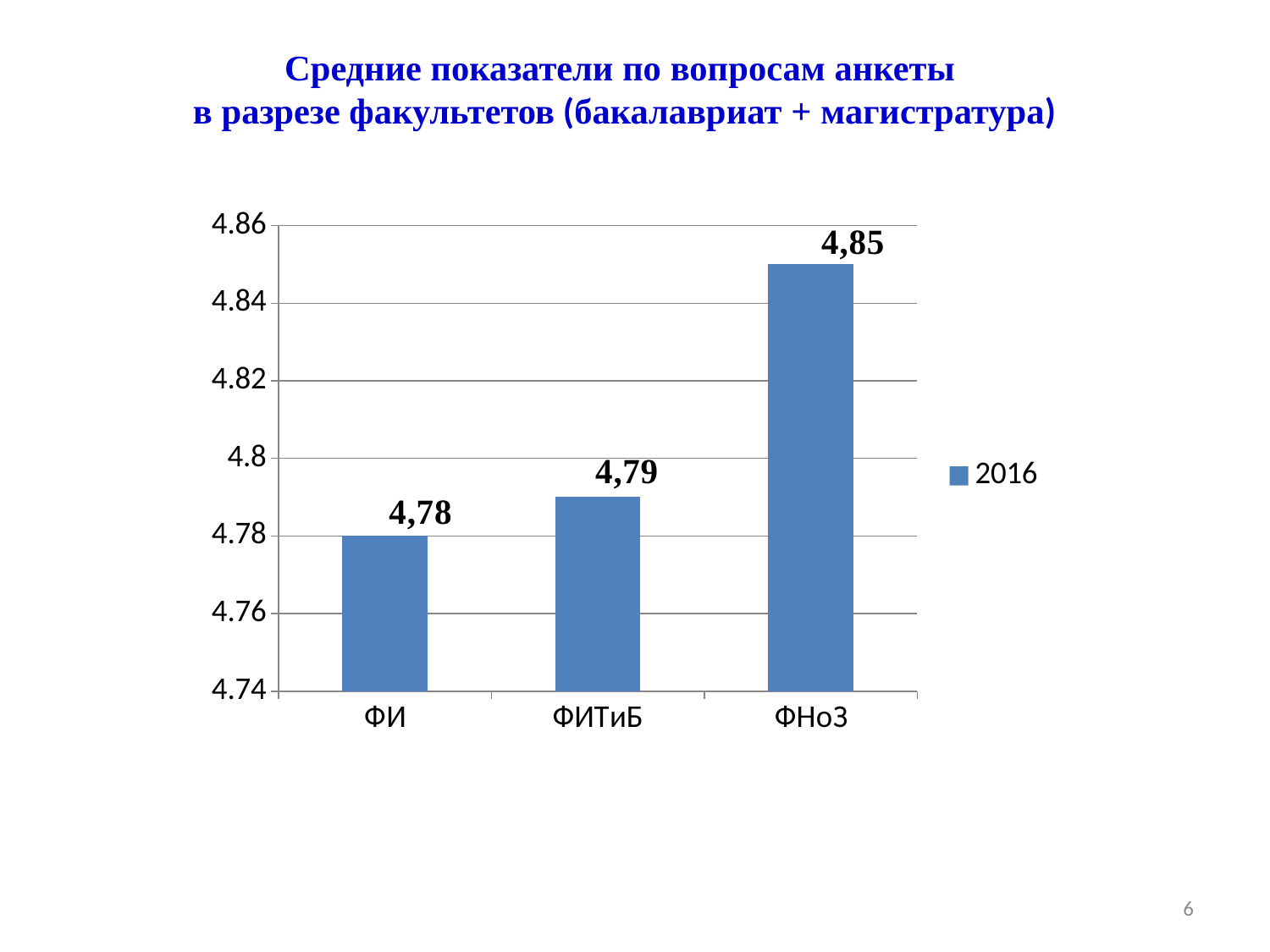
What kind of chart is shown on the slide? bar chart Which faculty has the lowest value? ФИ How many series does the legend list? 1 How many faculties are shown on the chart? 3 What is the difference between the values for ФНоЗ and ФИ? 0,07 Which faculty has the highest value? ФНоЗ What is the value for ФИ? 4,78 Is the value for ФНоЗ greater or less than 4.8? greater Which is larger, the value for ФИТиБ or the value for ФНоЗ? ФНоЗ What is the value for ФНоЗ? 4,85 What is the value for ФИТиБ? 4,79 What year is listed in the legend? 2016